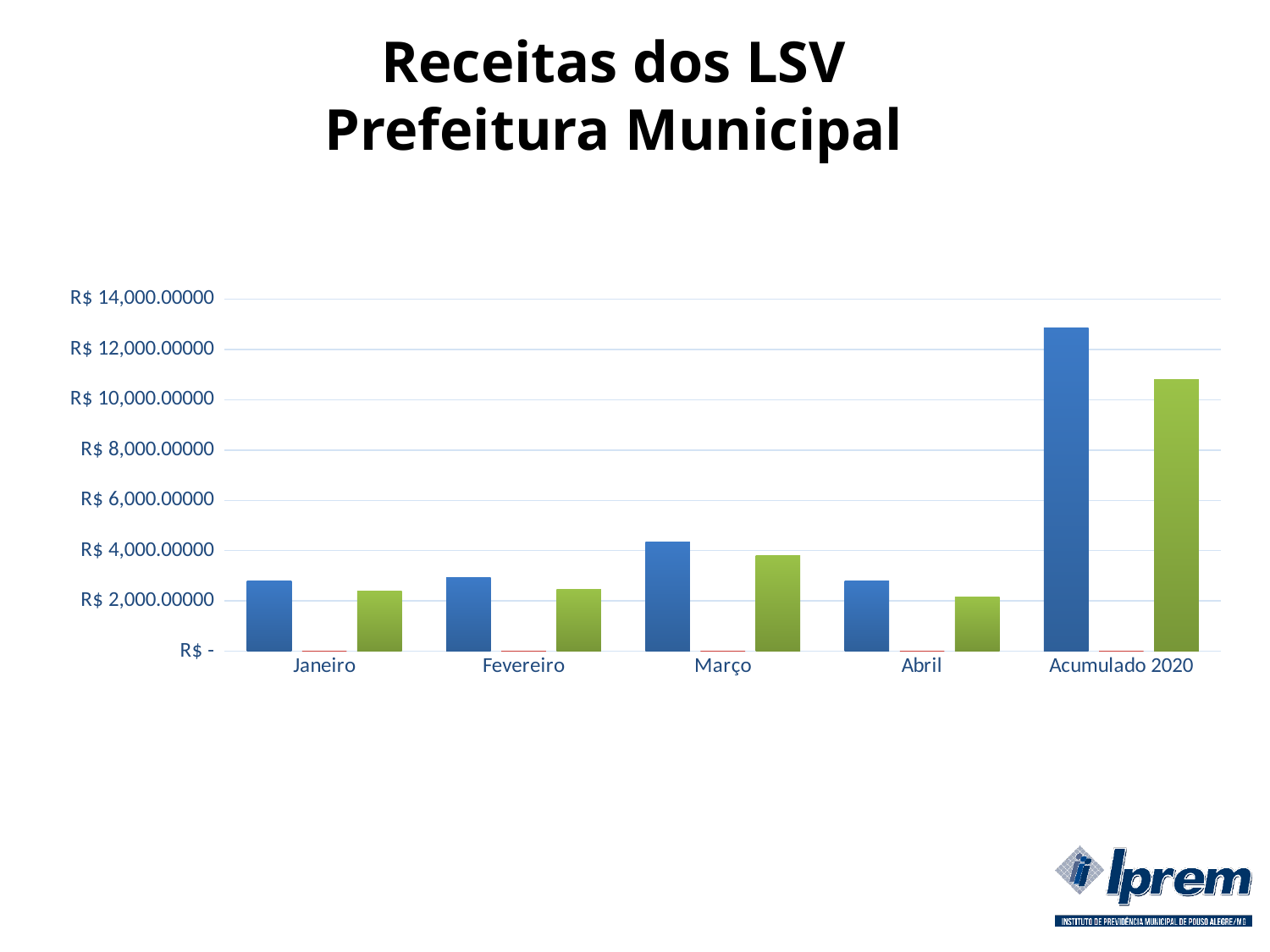
Is the green bar for Acumulado 2020 greater or less than R$ 10,000.00000? greater Which category has the tallest green bar? Acumulado 2020 Is the blue bar for Março greater or less than R$ 4,000.00000? greater Which category has the tallest blue bar? Acumulado 2020 What kind of chart is shown on the slide? bar chart In Março, which bar is taller, the blue bar or the green bar? the blue bar Among the months Janeiro, Fevereiro, Março and Abril, which has the tallest blue bar? Março Is the green bar for Março greater or less than R$ 4,000.00000? less What is the title of the chart on the slide? Receitas dos LSV Prefeitura Municipal Among the months Janeiro, Fevereiro, Março and Abril, which has the shortest green bar? Abril How many categories are shown along the x axis of the chart? 5